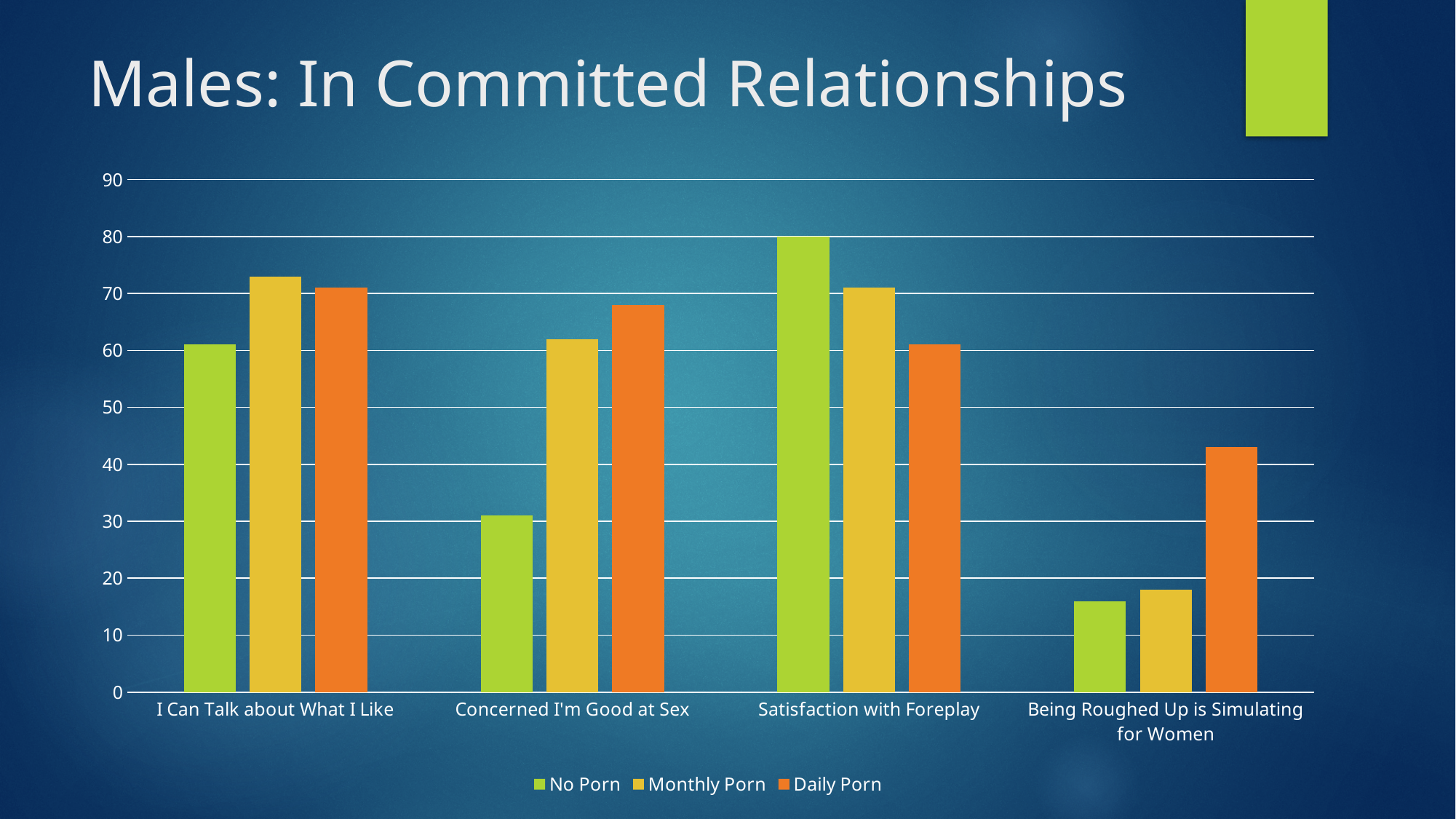
Is the No Porn value for Concerned I'm Good at Sex greater or less than 40? less For Satisfaction with Foreplay, which is larger: the No Porn value or the Daily Porn value? No Porn Do the Daily Porn values rise or fall from Satisfaction with Foreplay to Being Roughed Up is Simulating for Women? fall Is the Monthly Porn value for I Can Talk about What I Like greater or less than 70? greater What is the title of the chart on the slide? Males: In Committed Relationships How many categories are shown along the x axis? 4 Which series has the highest value for Satisfaction with Foreplay? No Porn Which series has the lowest value for Concerned I'm Good at Sex? No Porn How many series does the legend list? 3 Is the Daily Porn value for Being Roughed Up is Simulating for Women greater or less than 40? greater Which category has the lowest No Porn value? Being Roughed Up is Simulating for Women What kind of chart is shown on the slide? bar chart